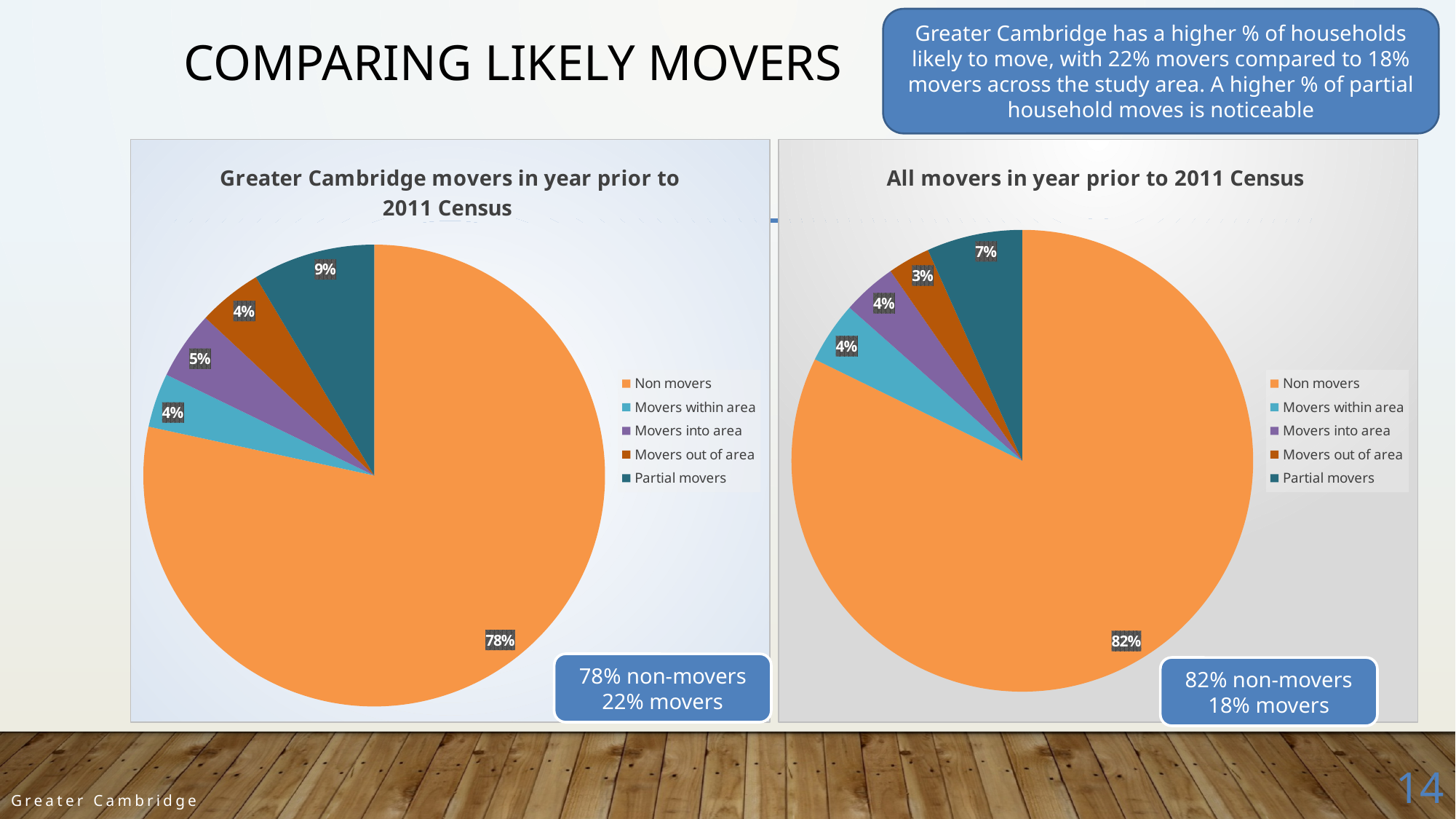
In the 'Greater Cambridge movers in year prior to 2011 Census' chart, what share of the pie is Non movers? 78% In the 'All movers in year prior to 2011 Census' chart, which category has the smallest slice? Movers out of area In the 'Greater Cambridge movers in year prior to 2011 Census' chart, which category has the largest slice? Non movers What is the difference between the Partial movers percentage in the 'Greater Cambridge movers in year prior to 2011 Census' chart and in the 'All movers in year prior to 2011 Census' chart? 2% Which chart shows a larger Non movers share, 'Greater Cambridge movers in year prior to 2011 Census' or 'All movers in year prior to 2011 Census'? All movers in year prior to 2011 Census In the 'Greater Cambridge movers in year prior to 2011 Census' chart, what percentage is shown for Partial movers? 9% How many categories does the legend of the 'Greater Cambridge movers in year prior to 2011 Census' chart list? 5 In the 'All movers in year prior to 2011 Census' chart, what share of the pie is Non movers? 82% In the 'All movers in year prior to 2011 Census' chart, what percentage is shown for Movers out of area? 3% In the 'All movers in year prior to 2011 Census' chart, what percentage is shown for Partial movers? 7% What type of chart is the 'All movers in year prior to 2011 Census' chart? Pie chart In the 'Greater Cambridge movers in year prior to 2011 Census' chart, what percentage is shown for Movers into area? 5%